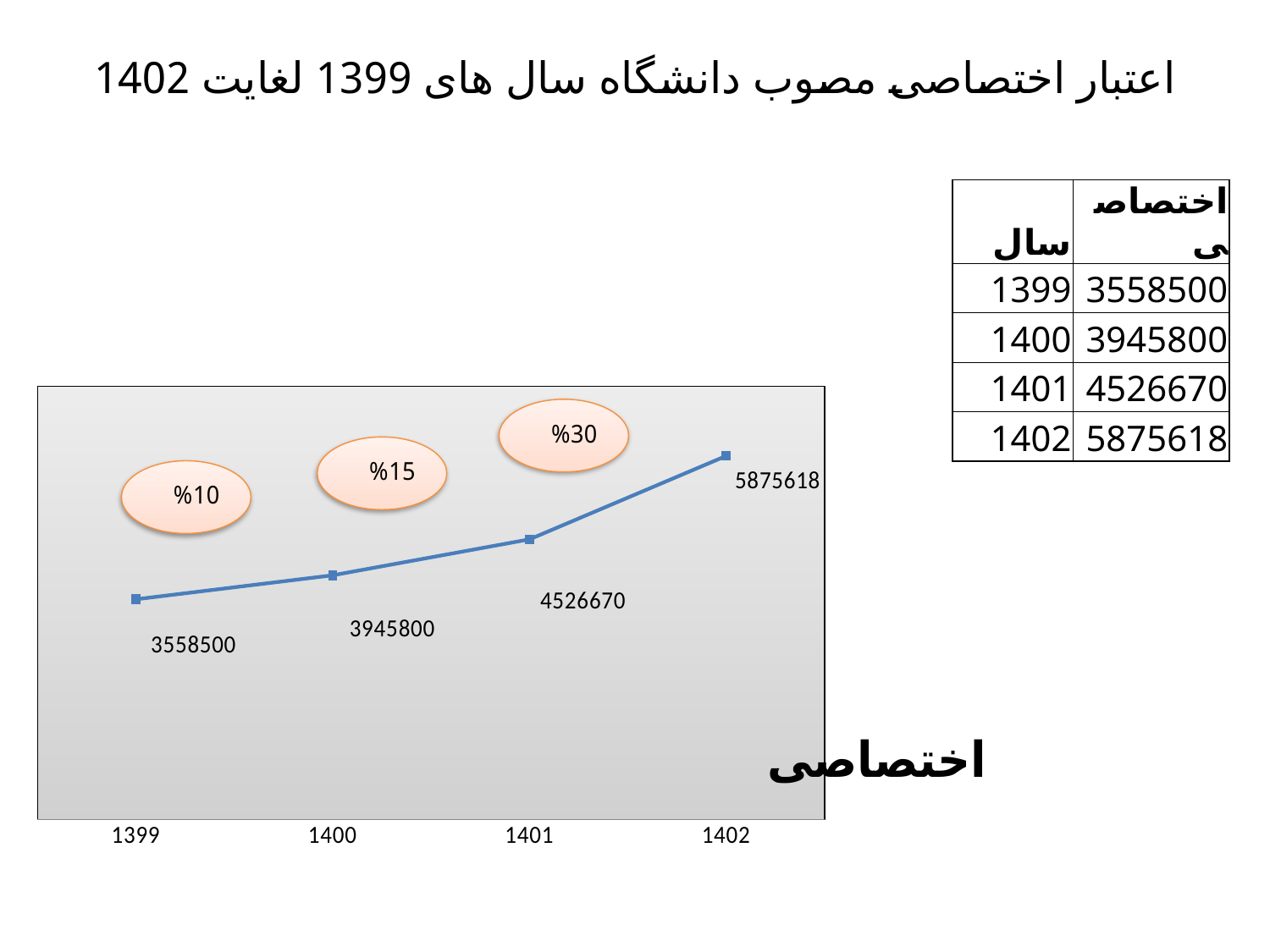
What type of chart is shown on the slide? line chart What is the value for 1401 on the chart? 4526670 What is the value for 1400 on the chart? 3945800 Do the values rise or fall from 1399 to 1402? rise What is the difference between the values for 1400 and 1399? 387300 What is the difference between the values for 1402 and 1401? 1348948 How many years are plotted on the chart? 4 Which year has the lowest value on the chart? 1399 Which is larger, the value for 1401 or the value for 1400? 1401 Which year has the highest value on the chart? 1402 What is the value for 1399 on the chart? 3558500 What is the value for 1402 on the chart? 5875618